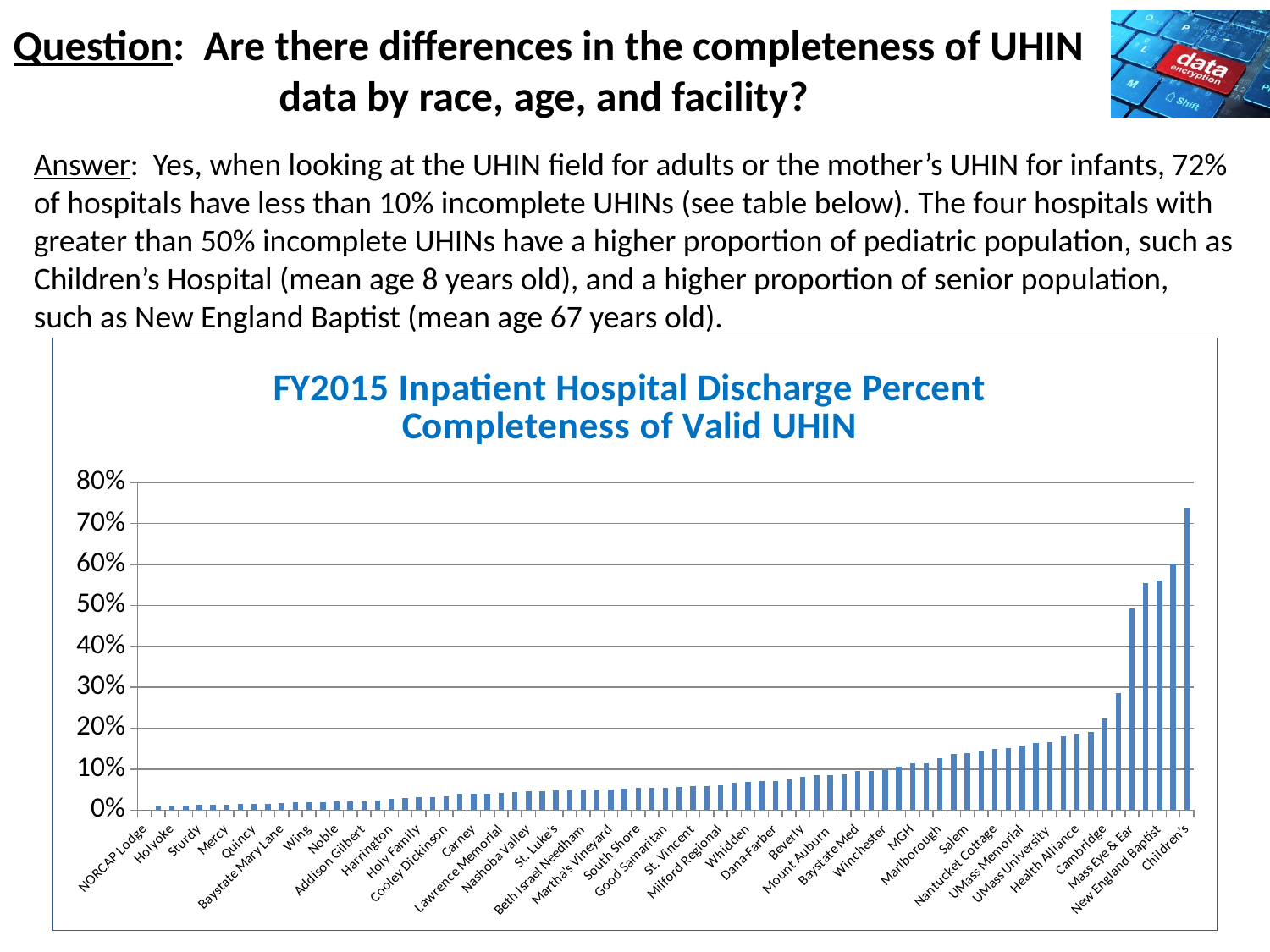
Is the value for Salem greater or less than 20%? less Do the values generally rise or fall moving from left to right along the x axis? rise What is the title of the chart? FY2015 Inpatient Hospital Discharge Percent Completeness of Valid UHIN Is the value for Holyoke greater or less than 10%? less Which is larger, the value for Children's or the value for NORCAP Lodge? Children's Which hospital has the highest value in the chart? Children's Which is larger, the value for Mass Eye & Ear or the value for Salem? Mass Eye & Ear Which hospital has the lowest value in the chart? NORCAP Lodge What kind of chart is shown on the slide? bar chart Is the value for Children's greater or less than 70%? greater